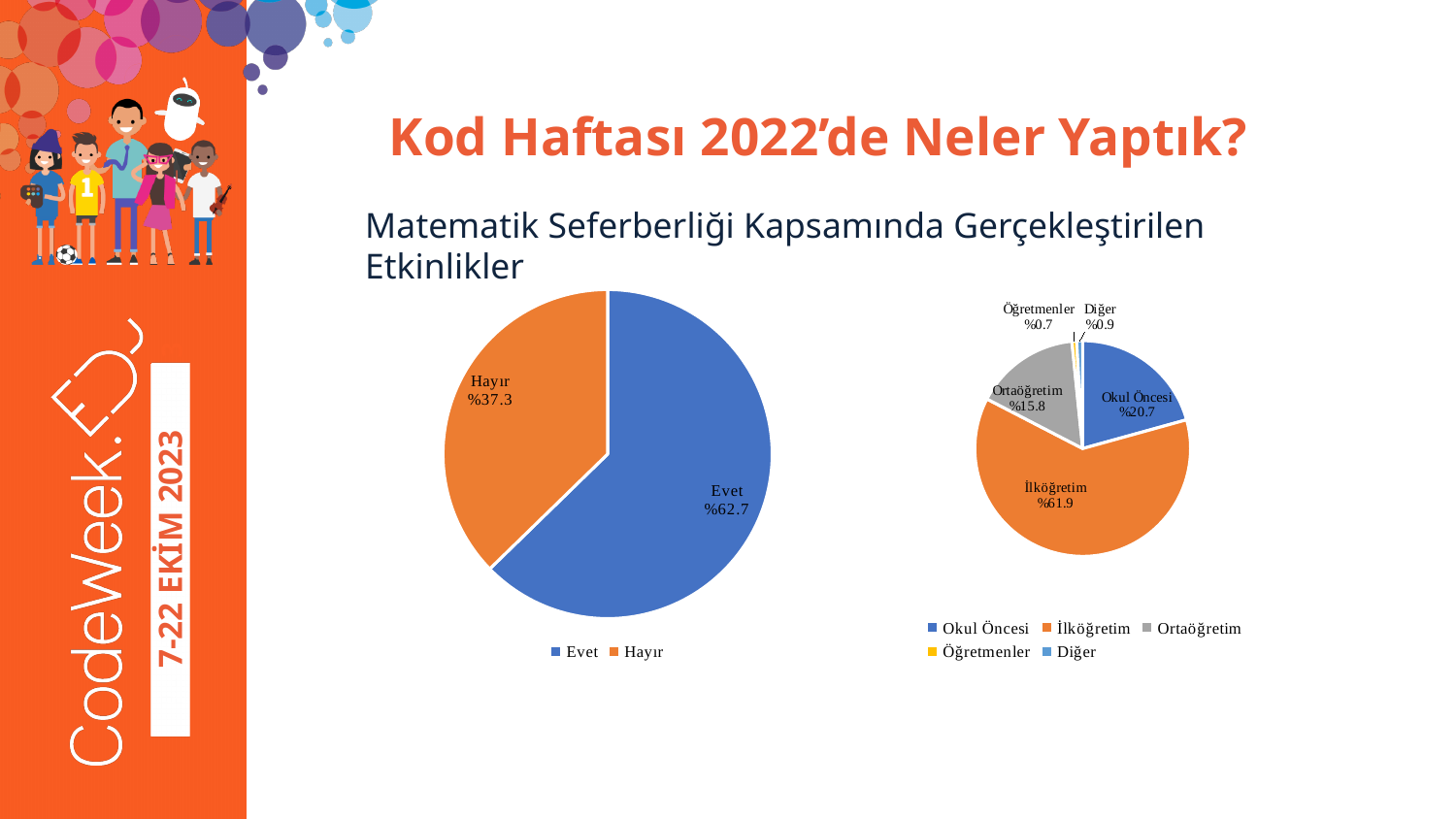
In the right pie chart, which category has the largest share? İlköğretim In the right pie chart, what share is labelled for Ortaöğretim? %15.8 In the left pie chart, what is the difference between the Evet and Hayır shares? 25.4 percentage points In the right pie chart, which category has the smallest share? Öğretmenler In the left pie chart, what share is labelled for Evet? %62.7 In the left pie chart, which slice is larger, Evet or Hayır? Evet In the right pie chart, what share is labelled for Okul Öncesi? %20.7 What type of chart is the chart on the left? Pie chart In the left pie chart, what share is labelled for Hayır? %37.3 How many categories does the legend of the right pie chart list? 5 In the right pie chart, what is the difference between the Okul Öncesi and Ortaöğretim shares? 4.9 percentage points In the right pie chart, what share is labelled for İlköğretim? %61.9